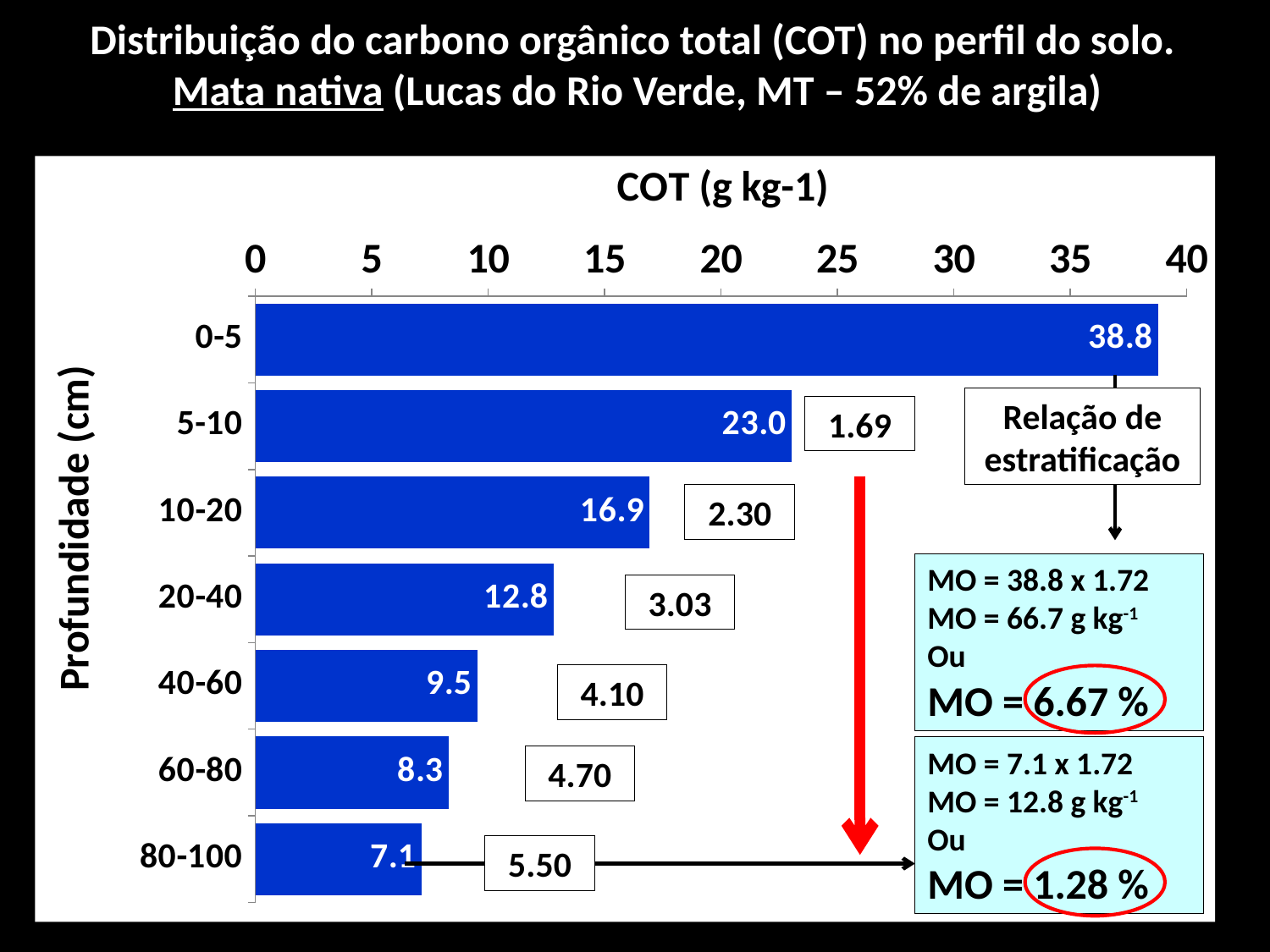
How many depth categories are shown in the chart? 7 What is the COT value for the 20-40 cm depth? 12.8 What is the COT value for the 80-100 cm depth? 7.1 Which depth has the highest COT value? 0-5 What is the difference in COT between the 40-60 and 60-80 cm depths? 1.2 What is the COT value for the 0-5 cm depth? 38.8 Do the COT values increase or decrease as depth increases from 0-5 to 80-100 cm? decrease What is the difference in COT between the 0-5 and 5-10 cm depths? 15.8 What kind of chart is shown on the slide? bar chart What is the label of the horizontal axis of the chart? COT (g kg-1) Which has a larger COT value, the 10-20 cm depth or the 20-40 cm depth? 10-20 Which depth has the lowest COT value? 80-100